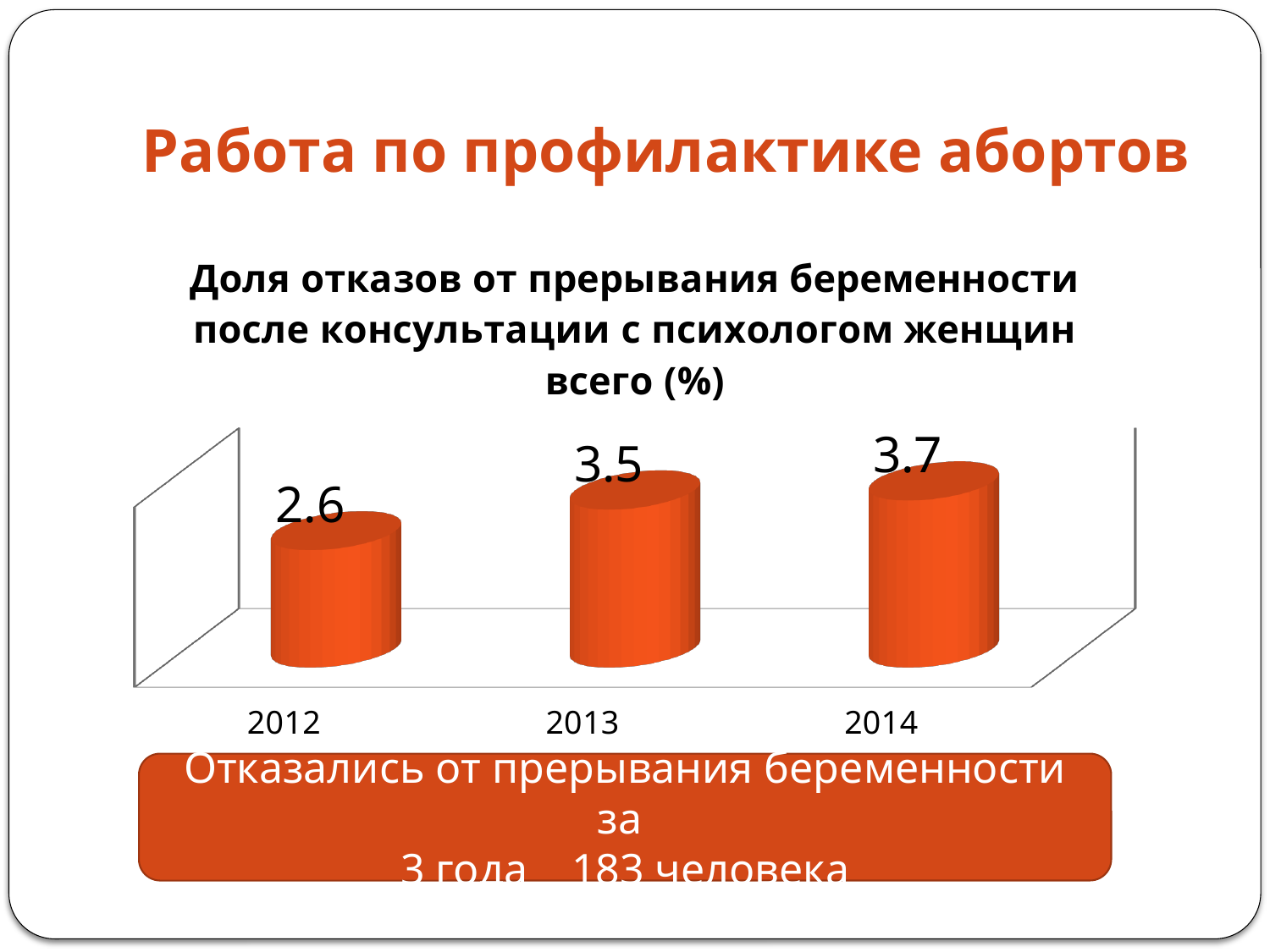
Which is larger, the value for 2013 or the value for 2012? 2013 Do the values rise or fall from 2012 to 2014? rise What colour are the bars in the chart? orange-red What is the value for 2014? 3.7 How many years are shown on the chart? 3 Which year has the highest value? 2014 What is the difference between the values for 2013 and 2012? 0.9 What is the difference between the values for 2014 and 2012? 1.1 What is the value for 2013? 3.5 What kind of chart is shown on the slide? bar chart Which year has the lowest value? 2012 What is the value for 2012? 2.6